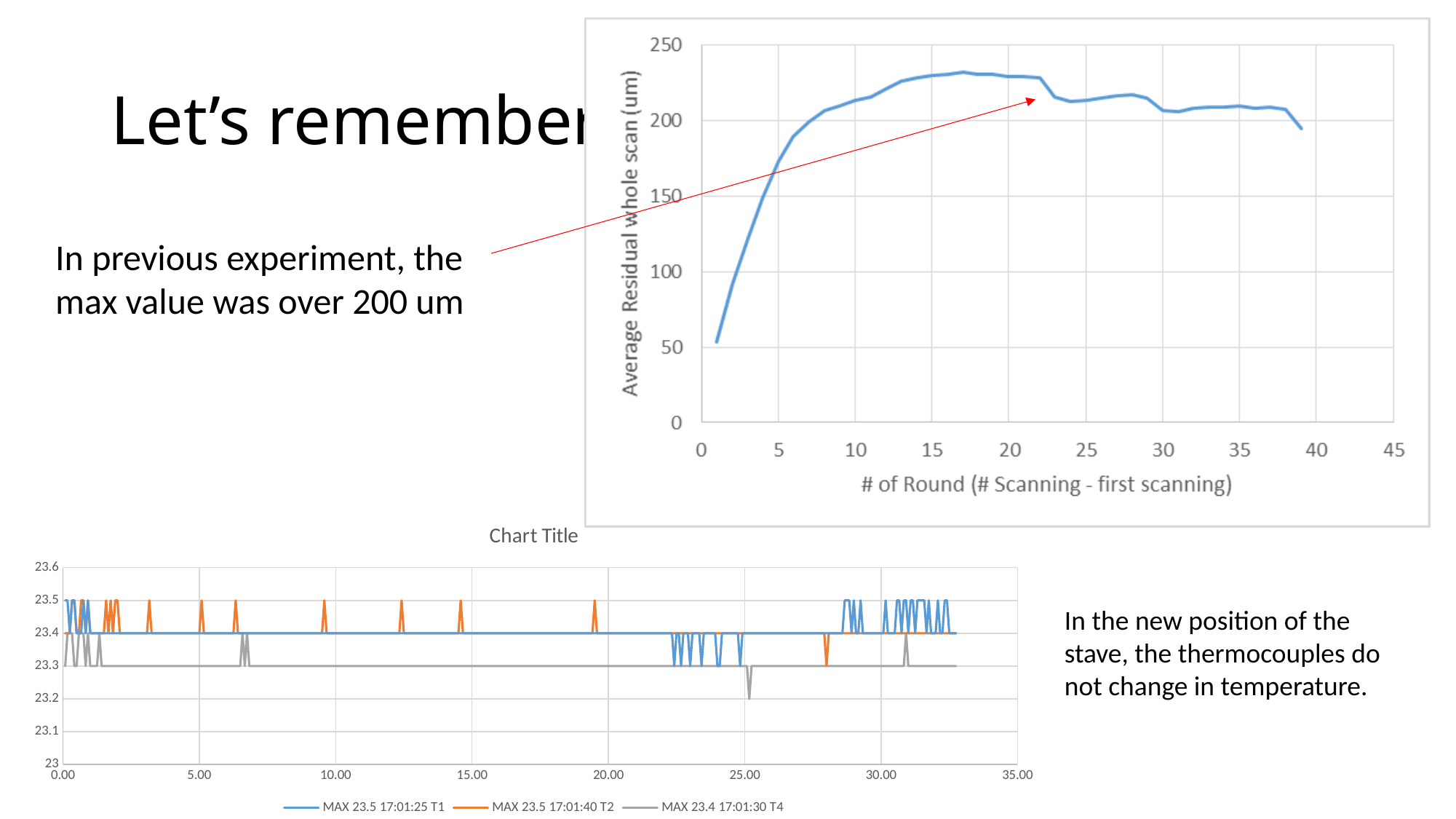
In the top-right chart, is the value at round 10 greater or less than 200? greater In the top-right chart, is the value at round 20 greater or less than 200? greater What type of chart is the top-right chart showing Average Residual whole scan? line chart In the top-right chart, what is the label of the y axis? Average Residual whole scan (um) In the top-right chart, does the value rise or fall between round 1 and round 15? rise What type of chart is the bottom chart titled 'Chart Title'? line chart In the top-right chart, is the value at round 1 greater or less than 100? less In the top-right chart, what is the label of the x axis? # of Round (# Scanning - first scanning) In the top-right chart, does the value rise or fall between round 30 and round 39? fall How many series does the legend of the bottom chart titled 'Chart Title' list? 3 In the bottom chart titled 'Chart Title', what is the lowest value reached by the series MAX 23.4 17:01:30 T4? 23.2